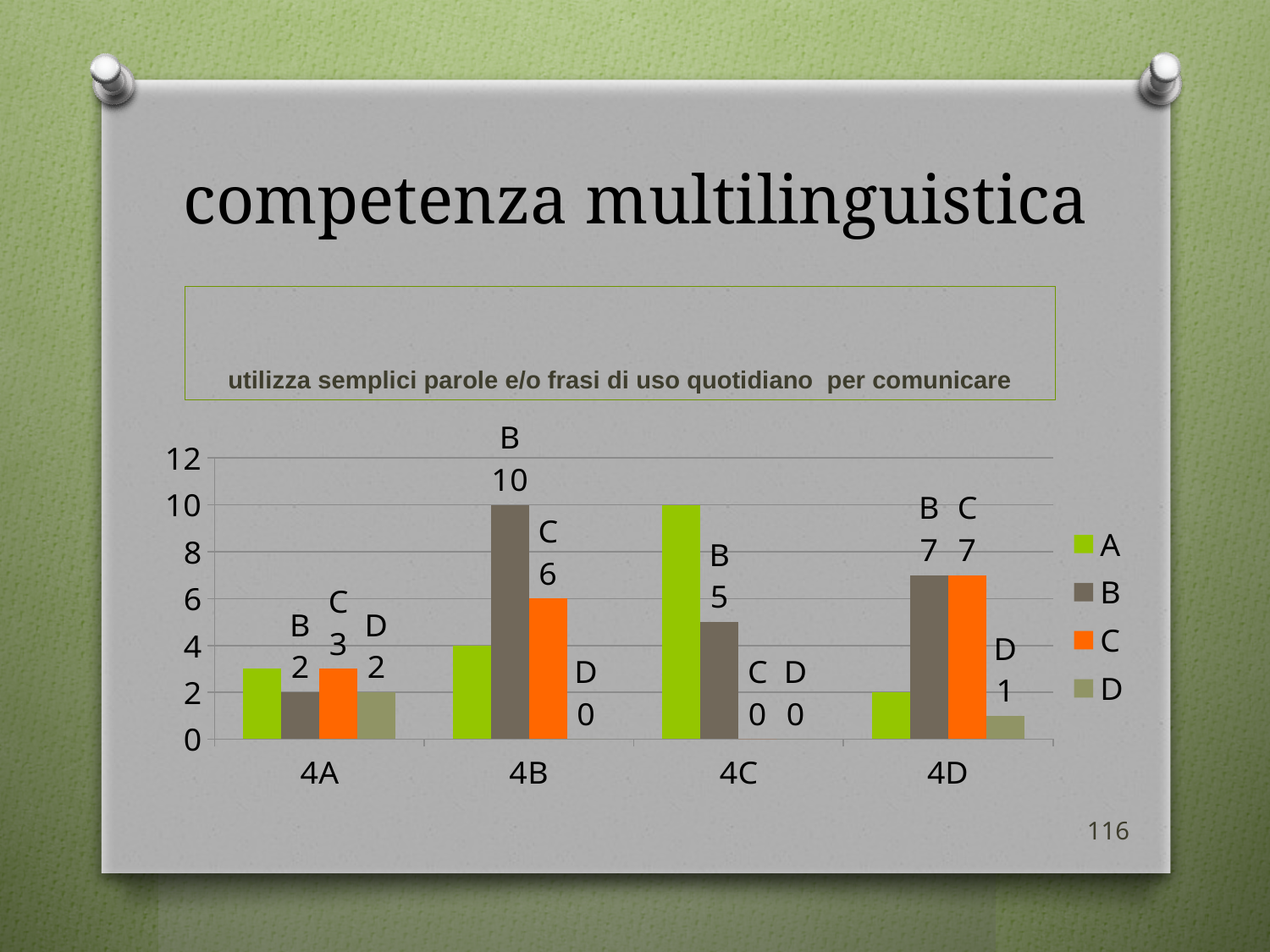
What kind of chart is shown on the slide? bar chart What is the value of series B for category 4B? 10 Which is larger: the value of series B for 4C or for 4D? 4D How many categories are shown on the x axis? 4 Which category has the highest value for series B? 4B What is the difference between the value of series C for 4B and for 4A? 3 What is the value of series D for category 4A? 2 Which category has the lowest value for series C? 4C Is the value of series A for category 4C greater or less than 8? greater How many series does the legend list? 4 What colour represents series C in the legend? orange What is the value of series C for category 4D? 7